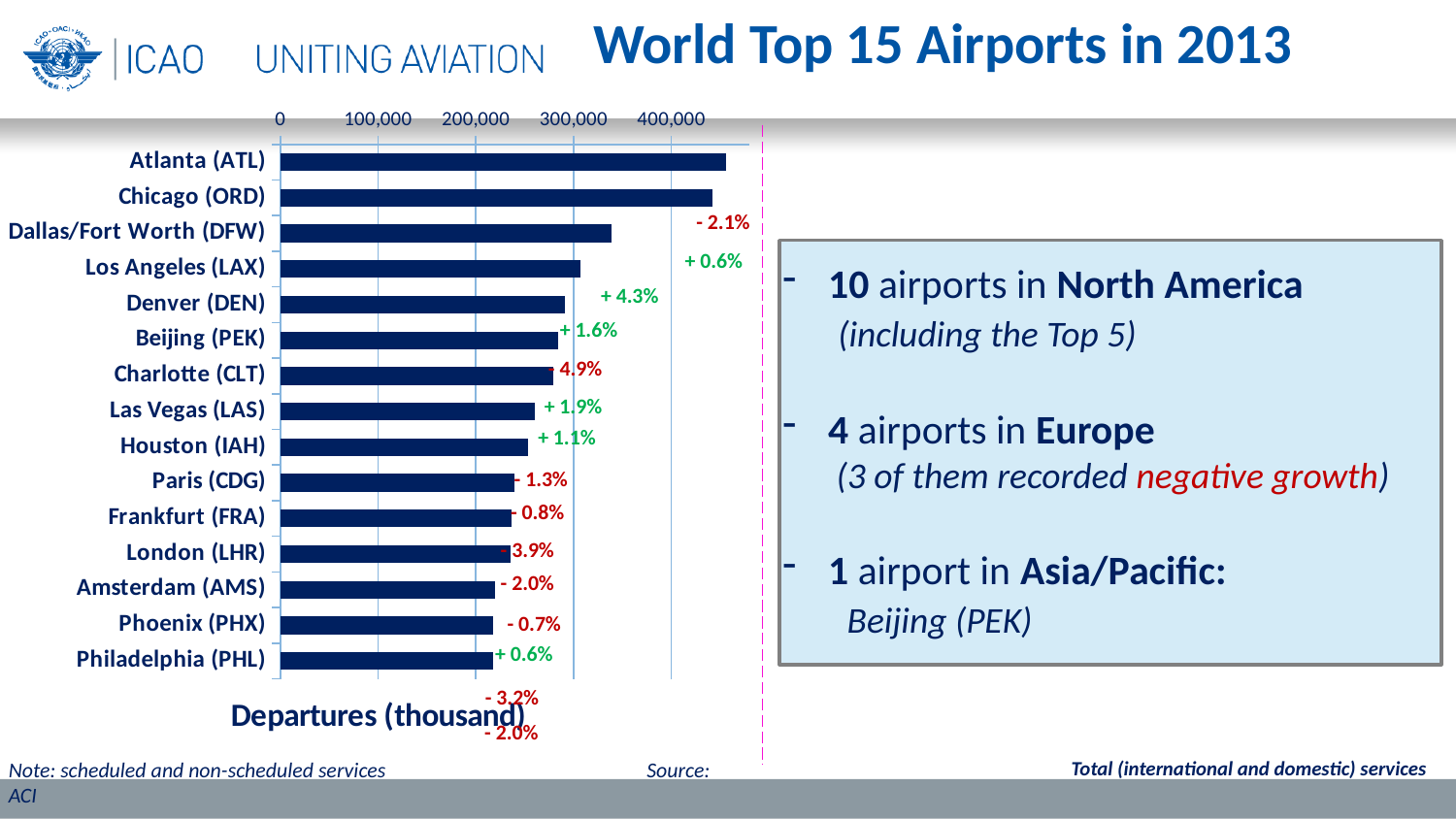
Do the bar values rise or fall going down the list from Atlanta (ATL) to Philadelphia (PHL)? fall How many airports are listed in the chart? 15 Is the value for Dallas/Fort Worth (DFW) greater or less than 300,000? greater Is the value for Philadelphia (PHL) greater or less than 200,000? greater Is the value for Atlanta (ATL) greater or less than 400,000? greater What is the axis title shown below the bars? Departures (thousand) Which has more departures, Chicago (ORD) or London (LHR)? Chicago (ORD) Which has more departures, Atlanta (ATL) or Dallas/Fort Worth (DFW)? Atlanta (ATL) What kind of chart is shown on the slide? bar chart Which airport has the highest number of departures in the chart? Atlanta (ATL)